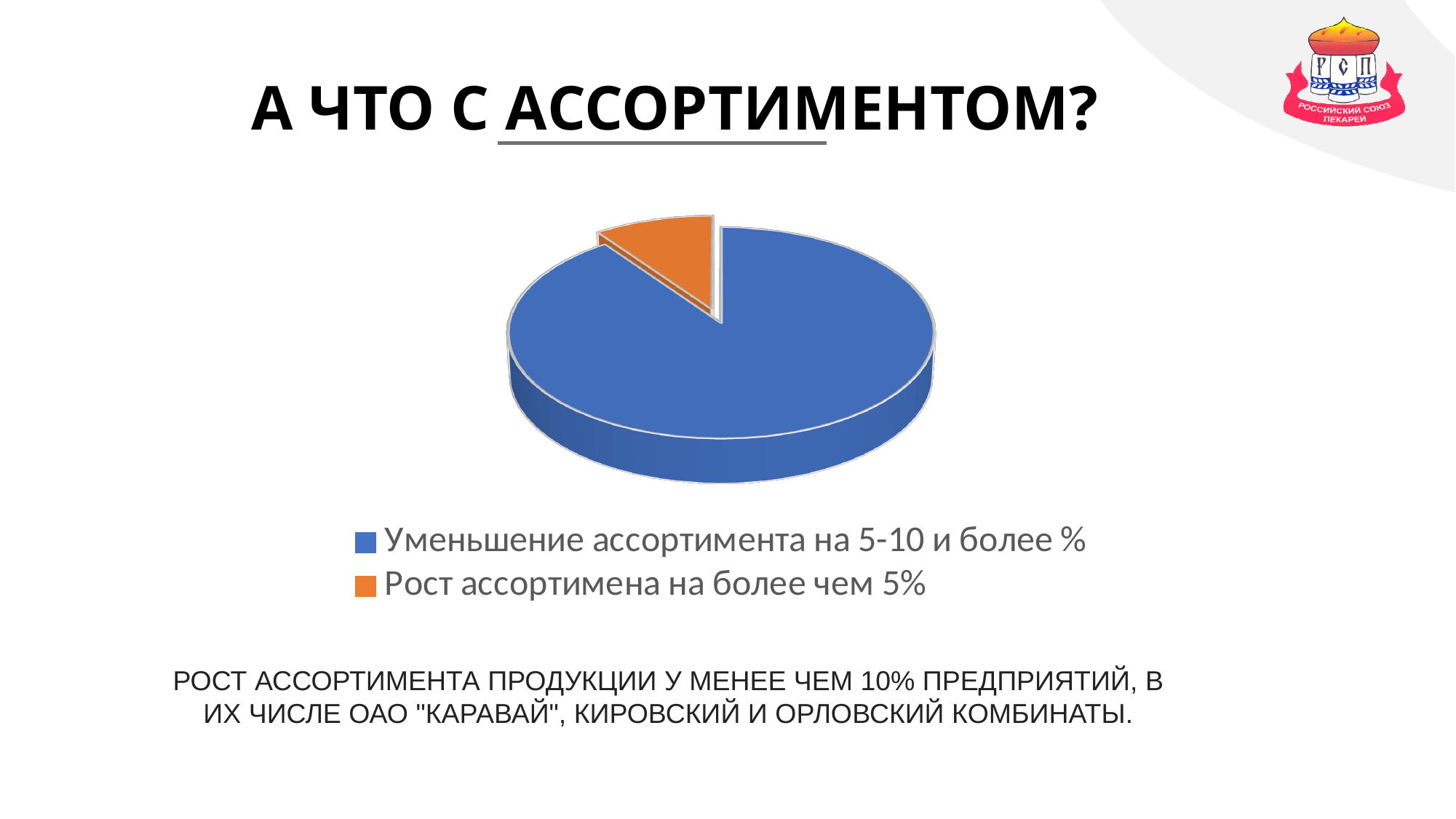
How many slices does the pie chart have? 2 Which category takes the smallest share of the pie chart? Рост ассортимена на более чем 5% What kind of chart is shown on the slide? Pie chart How many entries does the legend of the pie chart list? 2 Which slice is larger: "Уменьшение ассортимента на 5-10 и более %" or "Рост ассортимена на более чем 5%"? Уменьшение ассортимента на 5-10 и более % What colour is the slice for "Уменьшение ассортимента на 5-10 и более %"? Blue What colour is the slice for "Рост ассортимена на более чем 5%"? Orange Which category takes the largest share of the pie chart? Уменьшение ассортимента на 5-10 и более %